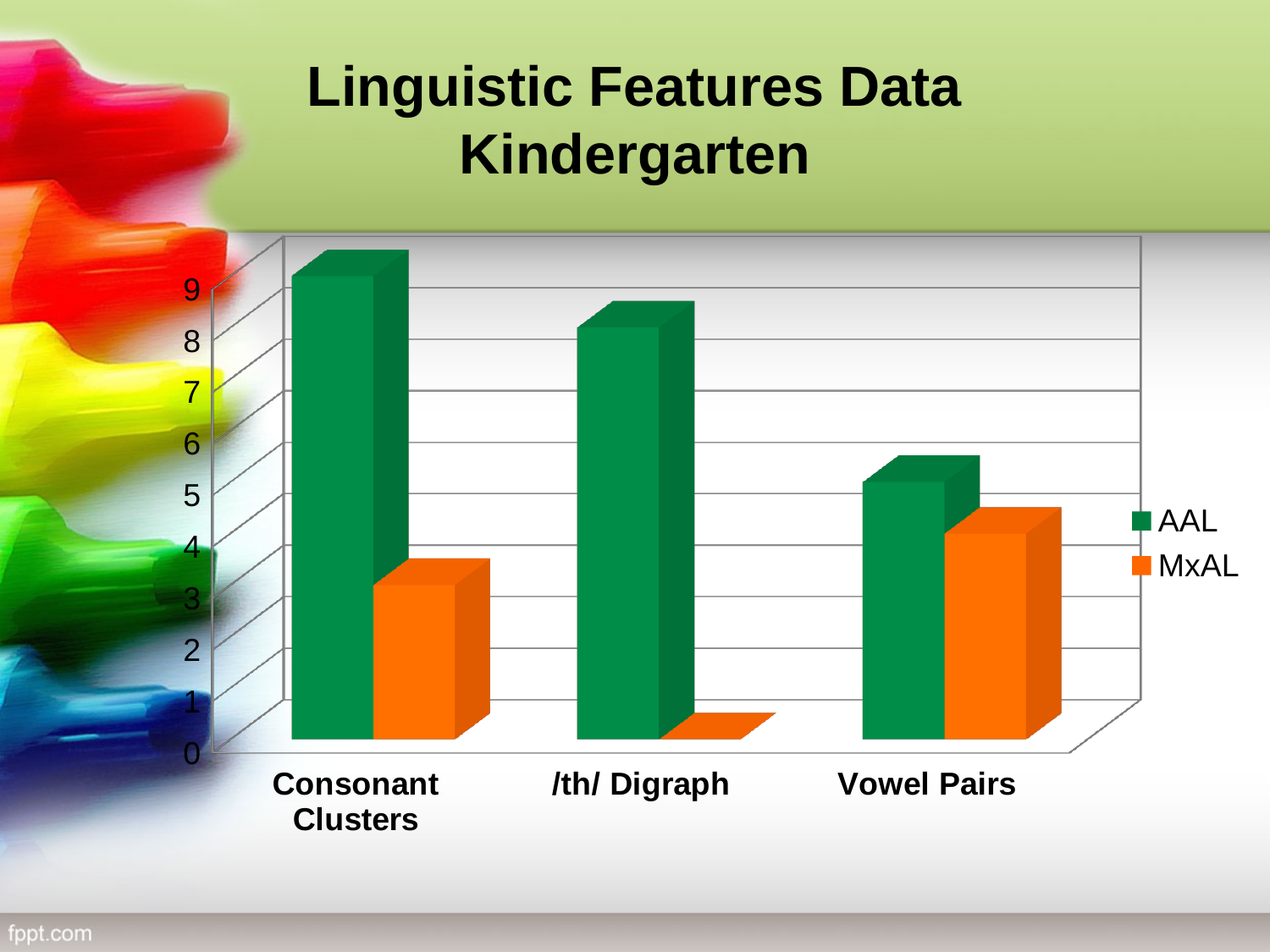
Which category has the lowest AAL value? Vowel Pairs Which is larger for Vowel Pairs, the AAL value or the MxAL value? AAL Which colour represents the MxAL series? orange What are the two series named in the legend? AAL and MxAL Is the MxAL value for Consonant Clusters greater or less than 5? less Is the AAL value for Consonant Clusters greater or less than 8? greater Which category has the highest MxAL value? Vowel Pairs How many categories are shown on the x axis? 3 Which category has the highest AAL value? Consonant Clusters How many series does the legend list? 2 Which category has the lowest MxAL value? /th/ Digraph What kind of chart is shown on the slide? bar chart